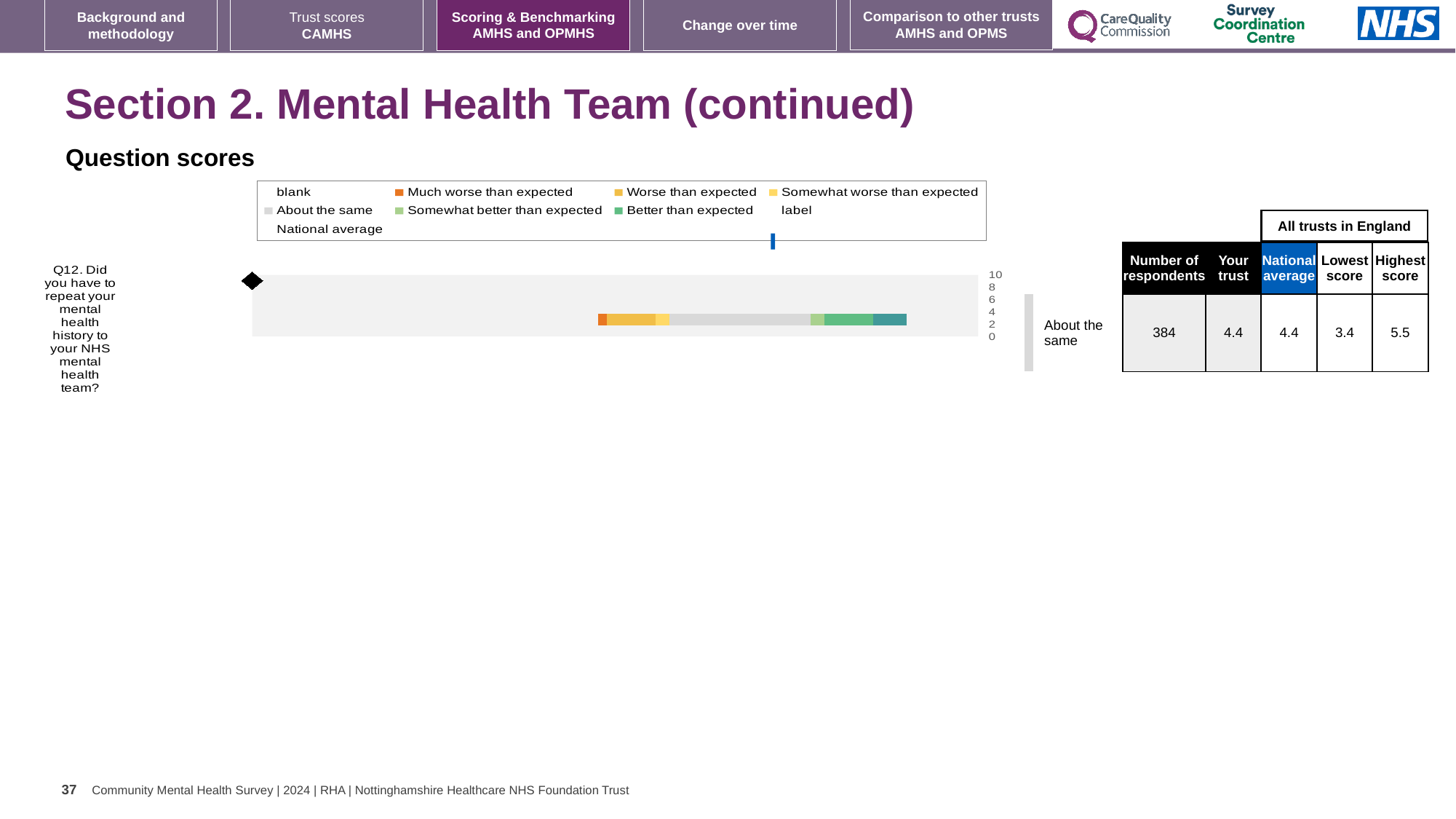
What is the difference between the highest score and the lowest score for Q12 in the table? 2.1 What benchmark label is shown to the right of the chart for Q12? About the same How many questions (categories) are plotted in the chart? 1 Which question is plotted in the chart? Q12. Did you have to repeat your mental health history to your NHS mental health team? In the table beside the chart, what is the number of respondents for Q12? 384 In the table beside the chart, what is the 'Your trust' score for Q12? 4.4 In the table beside the chart, what is the national average score for Q12? 4.4 In the table beside the chart, what is the lowest score among all trusts in England for Q12? 3.4 What kind of chart is shown on the slide? bar chart Is the 'Your trust' score for Q12 higher than, lower than, or equal to the national average? equal What is the highest value shown on the chart's axis? 10 In the table beside the chart, what is the highest score among all trusts in England for Q12? 5.5